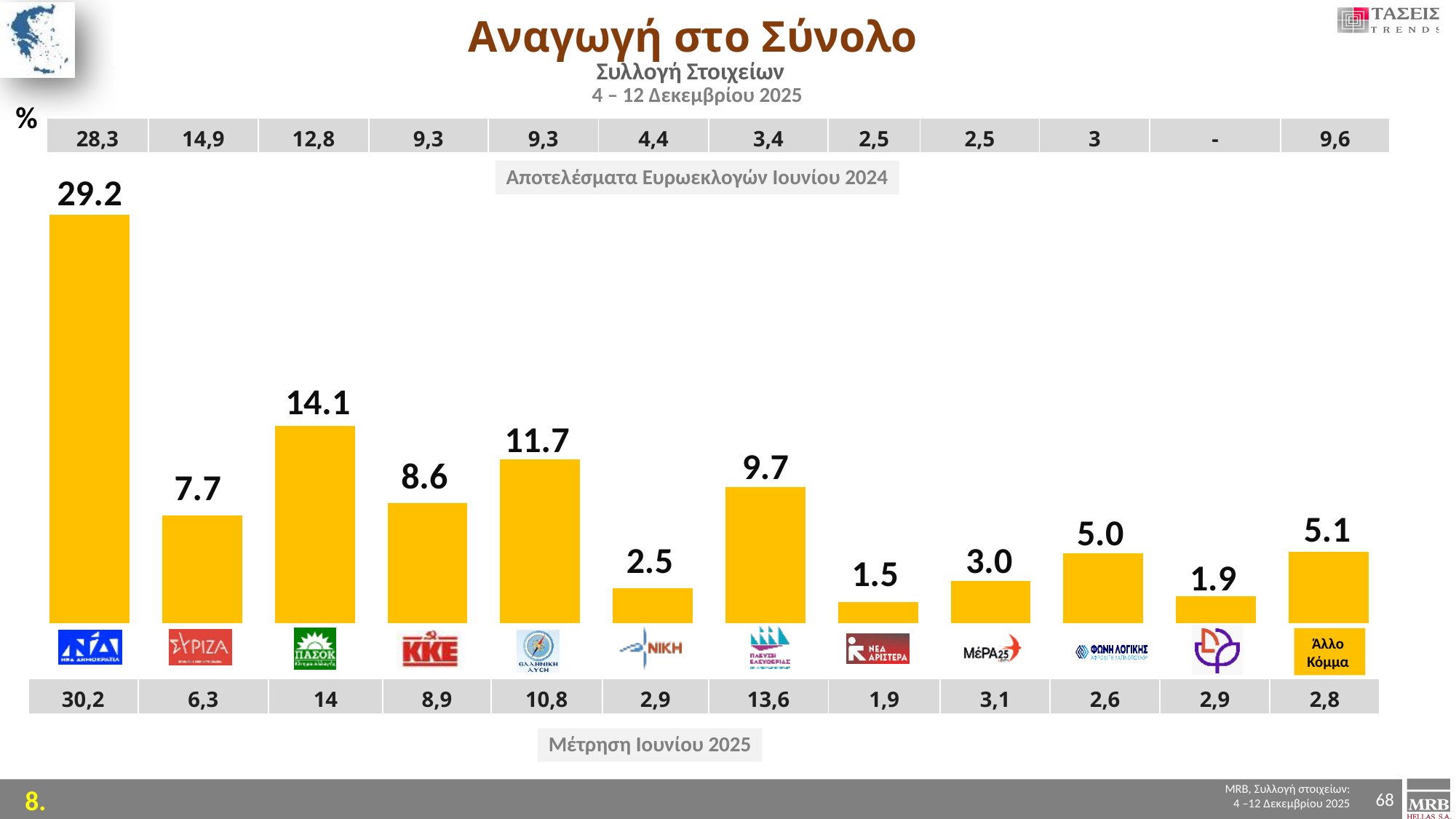
What value is shown for Άλλο Κόμμα in the bar chart? 5.1 How many bars are plotted in the chart? 12 Which has a larger bar value, Ελληνική Λύση or ΚΚΕ? Ελληνική Λύση What is the difference between the bar values for ΠΑΣΟΚ and ΣΥΡΙΖΑ? 6.4 In the row labelled Αποτελέσματα Ευρωεκλογών Ιουνίου 2024 above the chart, what value is shown for ΣΥΡΙΖΑ? 14,9 What value is shown for Πλεύση Ελευθερίας in the bar chart? 9.7 Which party has the highest bar in the chart? ΝΔ (Νέα Δημοκρατία) What value is shown for ΠΑΣΟΚ in the bar chart? 14.1 What value is shown for ΝΔ (Νέα Δημοκρατία) in the bar chart? 29.2 In the row labelled Μέτρηση Ιουνίου 2025 below the chart, what value is shown for Πλεύση Ελευθερίας? 13,6 Which party has the lowest bar in the chart? Νέα Αριστερά What kind of chart is shown on the slide? Bar chart